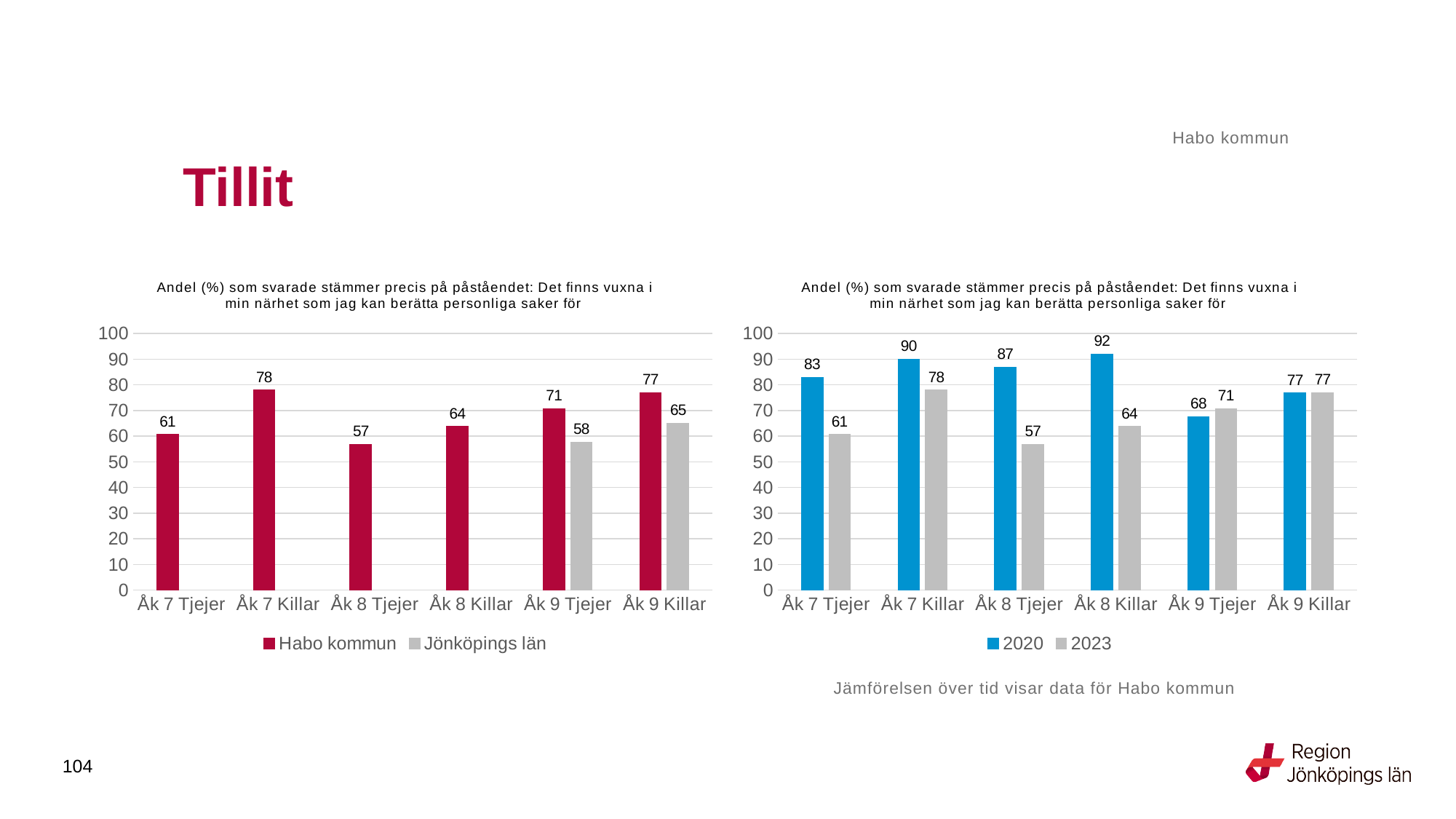
In the left chart, how many series does the legend list? 2 In the right chart, what is the 2023 value for Åk 9 Tjejer? 71 In the right chart, which is larger for Åk 9 Tjejer, the 2020 value or the 2023 value? 2023 How many categories are shown on the x axis of the right chart? 6 In the right chart, what is the 2020 value for Åk 8 Killar? 92 In the left chart, what is the value for Habo kommun for Åk 7 Killar? 78 In the right chart, what is the difference between the 2020 and 2023 values for Åk 8 Tjejer? 30 In the left chart, which category has the lowest Habo kommun value? Åk 8 Tjejer In the left chart, what is the value for Jönköpings län for Åk 9 Killar? 65 In the right chart, which category has the highest 2020 value? Åk 8 Killar What kind of chart is the right chart? Bar chart In the left chart, what is the difference between the Habo kommun and Jönköpings län values for Åk 9 Tjejer? 13